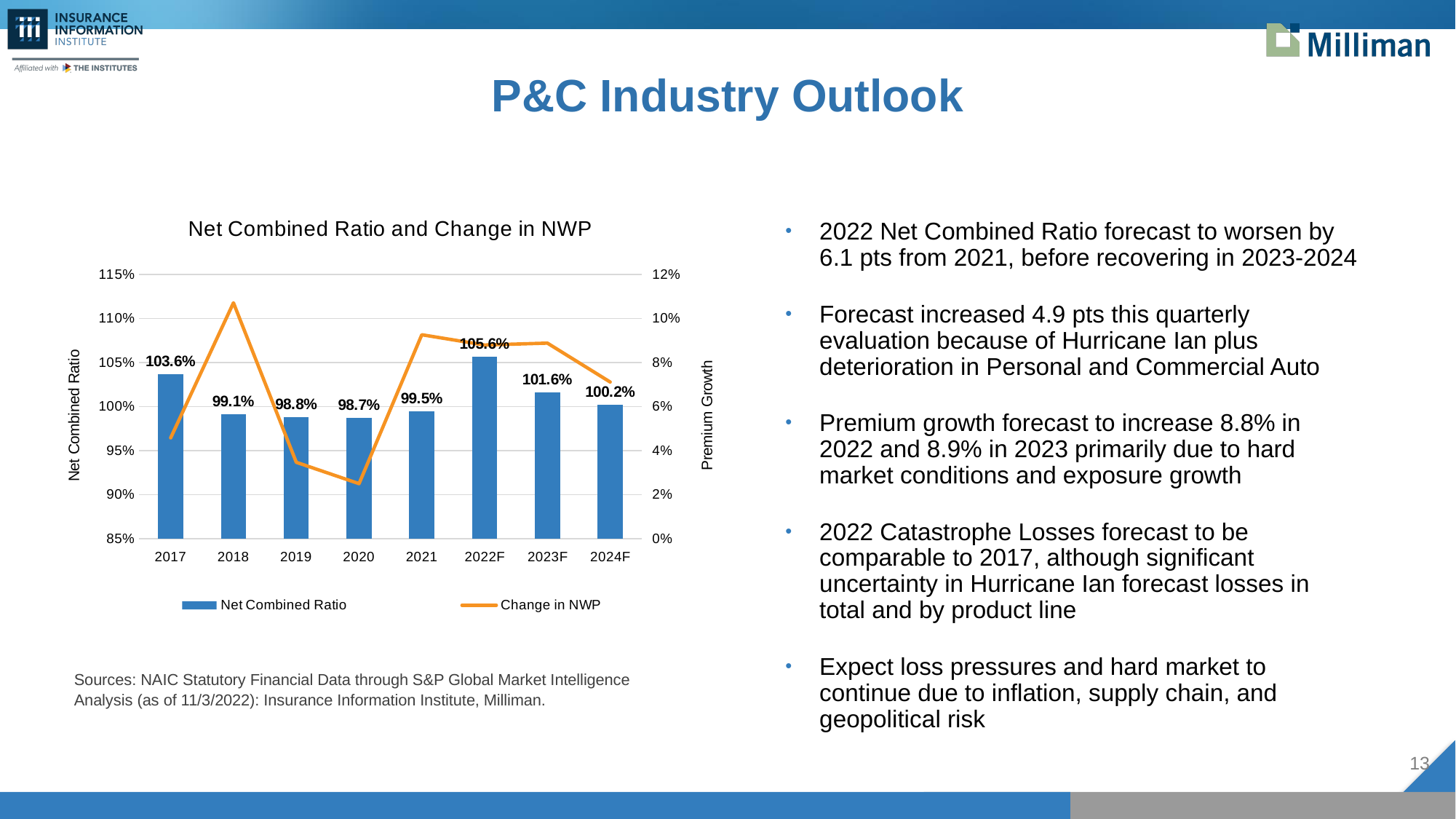
Is the Change in NWP for 2020 greater or less than 4%? less Which year has the highest Net Combined Ratio? 2022F How many series does the chart legend list? 2 What is the Net Combined Ratio for 2022F? 105.6% What type of chart is used to show the Net Combined Ratio? Bar chart How many years are shown on the x axis of the chart? 8 Which year has the lowest Net Combined Ratio? 2020 Which is larger, the Net Combined Ratio for 2017 or for 2023F? 2017 By how many percentage points does the Net Combined Ratio for 2022F exceed that for 2021? 6.1 percentage points What is the Net Combined Ratio for 2020? 98.7% Is the Change in NWP for 2018 greater or less than 10%? greater What is the title of the chart? Net Combined Ratio and Change in NWP